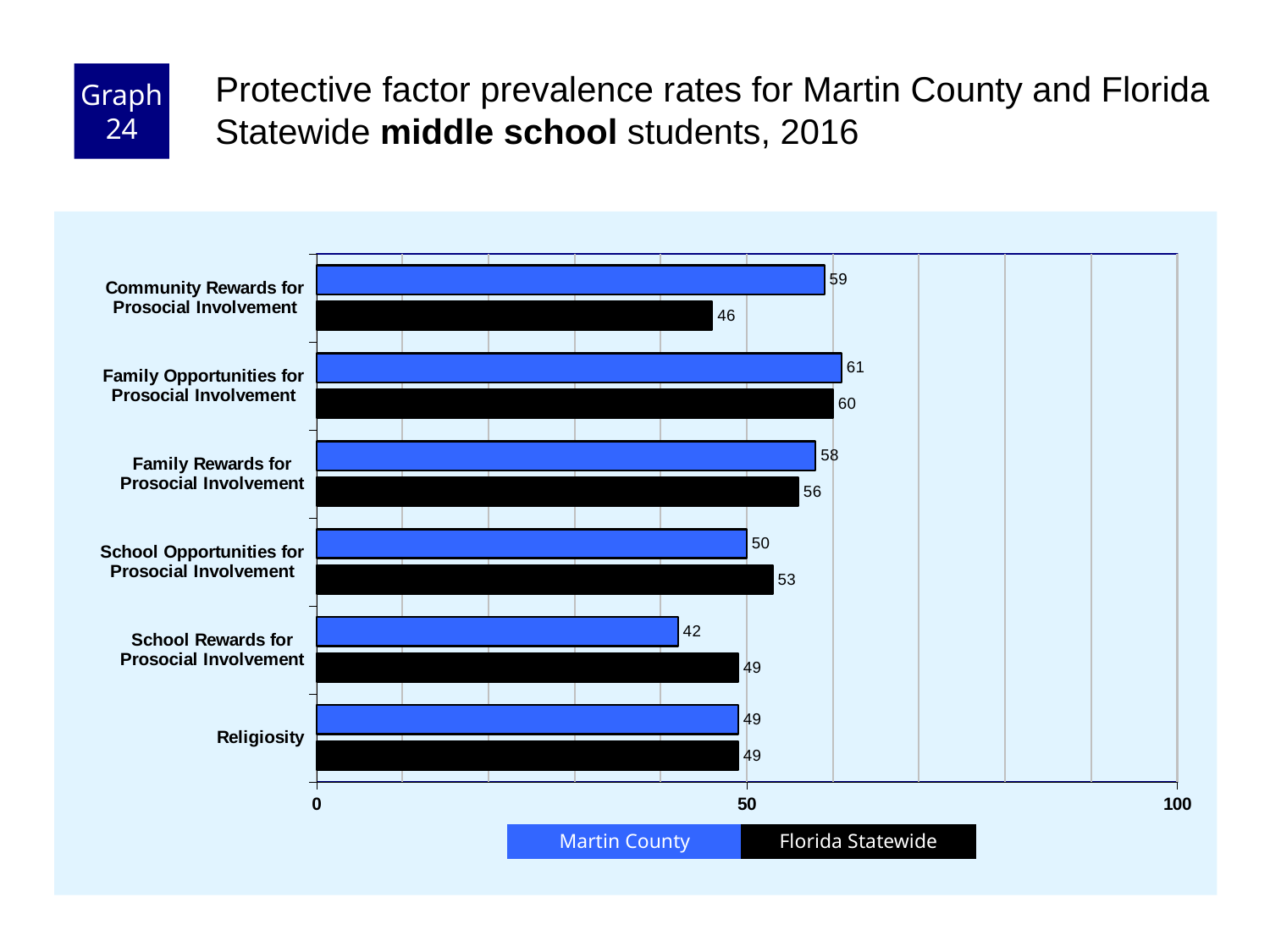
Which category has the highest Martin County value? Family Opportunities for Prosocial Involvement What colour are the Florida Statewide bars? Black Which category has the lowest Florida Statewide value? Community Rewards for Prosocial Involvement How many categories are shown on the chart? 6 Which is larger for School Rewards for Prosocial Involvement: the Martin County value or the Florida Statewide value? Florida Statewide What is the Martin County value for Community Rewards for Prosocial Involvement? 59 How many series does the legend list? 2 What is the difference between the Martin County and Florida Statewide values for Community Rewards for Prosocial Involvement? 13 What kind of chart is shown on the slide? Bar chart What is the Florida Statewide value for School Opportunities for Prosocial Involvement? 53 Is the Florida Statewide value for Family Rewards for Prosocial Involvement greater or less than 50? greater What is the Martin County value for School Rewards for Prosocial Involvement? 42